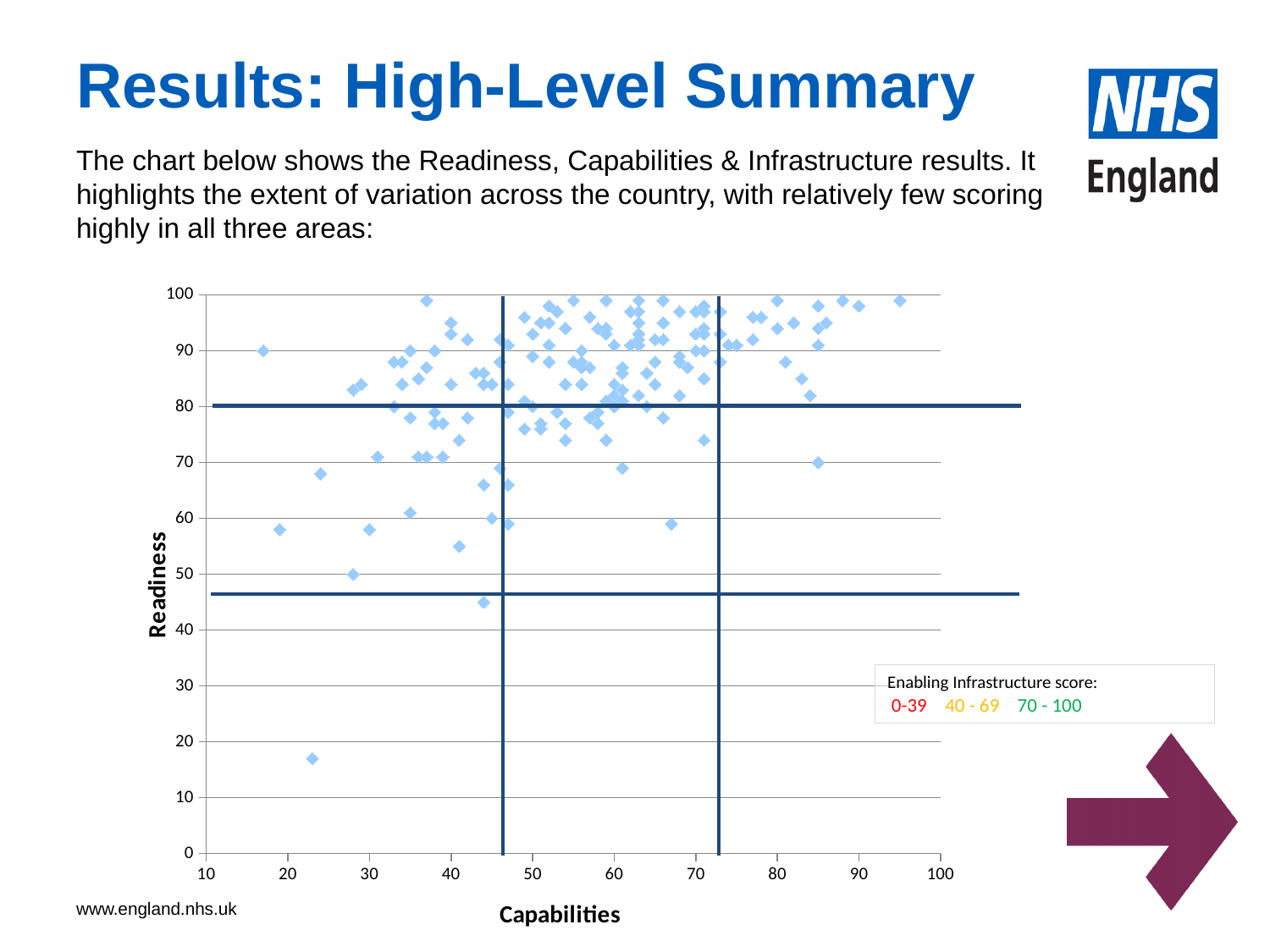
What kind of chart is shown on the slide? scatter chart Is the Capabilities value of the lowest point on the chart greater or less than 30? less Is the Capabilities value of the leftmost point on the chart greater or less than 20? less Do Readiness values generally rise or fall as Capabilities increase along the x axis? rise What is the lowest value shown on the Capabilities axis? 10 What is the title of the horizontal axis of the chart? Capabilities Is the Readiness value of the leftmost point on the chart greater or less than 80? greater What is the highest value shown on the Readiness axis? 100 What is the title of the vertical axis of the chart? Readiness